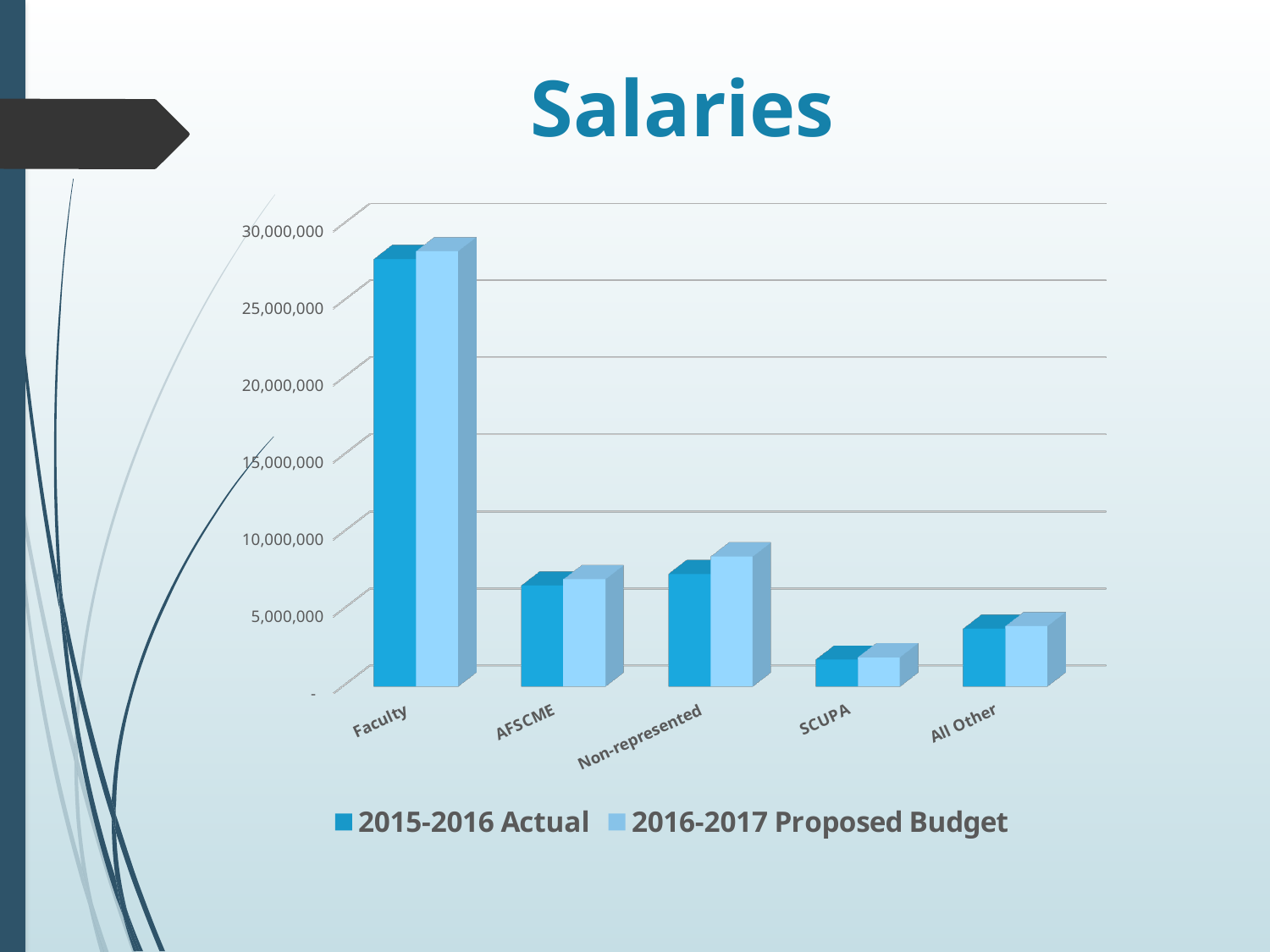
What are the two series named in the legend? 2015-2016 Actual and 2016-2017 Proposed Budget In the 2016-2017 Proposed Budget series, which is larger: Non-represented or AFSCME? Non-represented What is the title of the chart? Salaries Which category has the lowest salaries in the 2016-2017 Proposed Budget series? SCUPA Is the 2016-2017 Proposed Budget value for All Other greater or less than 5,000,000? less What type of chart is shown on the slide? Bar chart Is the 2015-2016 Actual value for Faculty greater or less than 25,000,000? greater Is the 2016-2017 Proposed Budget value for SCUPA greater or less than 5,000,000? less Which category has the highest salaries in the 2015-2016 Actual series? Faculty How many series does the legend list? 2 How many categories are shown on the x axis? 5